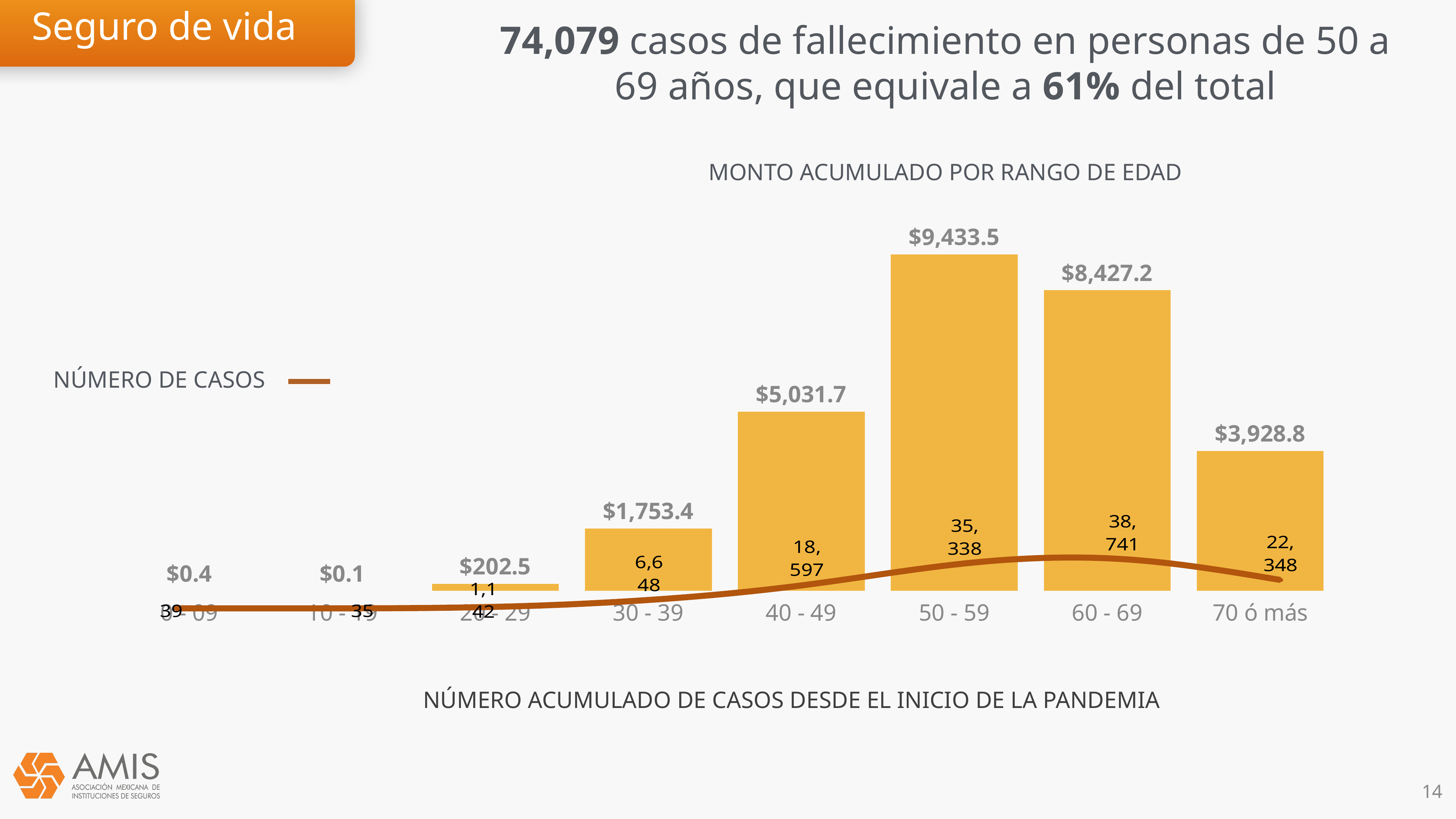
What is the accumulated amount (monto acumulado) for the 50 - 59 age range? $9,433.5 What is the difference in accumulated amount between the 50 - 59 and 60 - 69 age ranges? $1,006.3 What is the accumulated amount for the 30 - 39 age range? $1,753.4 How many age ranges are shown on the x axis? 8 Which has a larger accumulated amount, 40 - 49 or 70 ó más? 40 - 49 What is the accumulated amount for the 20 - 29 age range? $202.5 What is the number of cases for the 70 ó más age range? 22,348 What does the line series in the legend represent? NÚMERO DE CASOS What is the number of cases for the 60 - 69 age range? 38,741 Which age range has the highest accumulated amount? 50 - 59 What kind of chart is shown on the slide? Bar chart with a line Which age range has the highest number of cases? 60 - 69